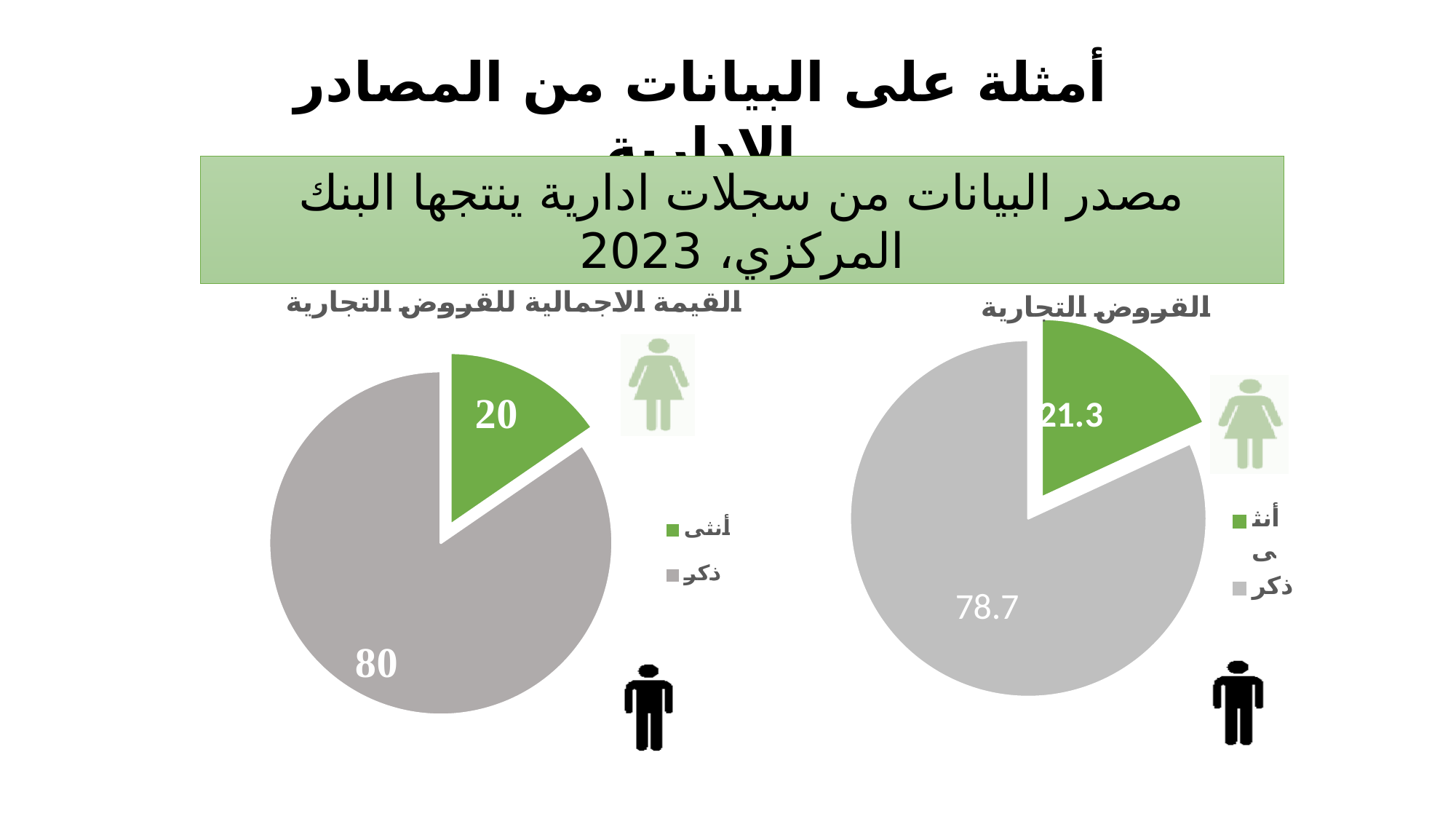
In the left chart titled القيمة الاجمالية للقروض التجارية, what is the value for ذكر? 80 In the left chart titled القيمة الاجمالية للقروض التجارية, what is the value for أنثى? 20 In the left chart titled القيمة الاجمالية للقروض التجارية, what colour is the slice for أنثى? green In the right chart titled القروض التجارية, what is the difference between the values for ذكر and أنثى? 57.4 In the right chart titled القروض التجارية, which is larger, the value for أنثى or the value for ذكر? ذكر In the left chart titled القيمة الاجمالية للقروض التجارية, which category has the largest slice? ذكر What type of chart is the left chart titled القيمة الاجمالية للقروض التجارية? pie chart In the right chart titled القروض التجارية, what is the value for أنثى? 21.3 How many slices does the right chart titled القروض التجارية have? 2 In the right chart titled القروض التجارية, which category has the smallest slice? أنثى In the right chart titled القروض التجارية, what is the value for ذكر? 78.7 In the left chart titled القيمة الاجمالية للقروض التجارية, what is the difference between the values for ذكر and أنثى? 60